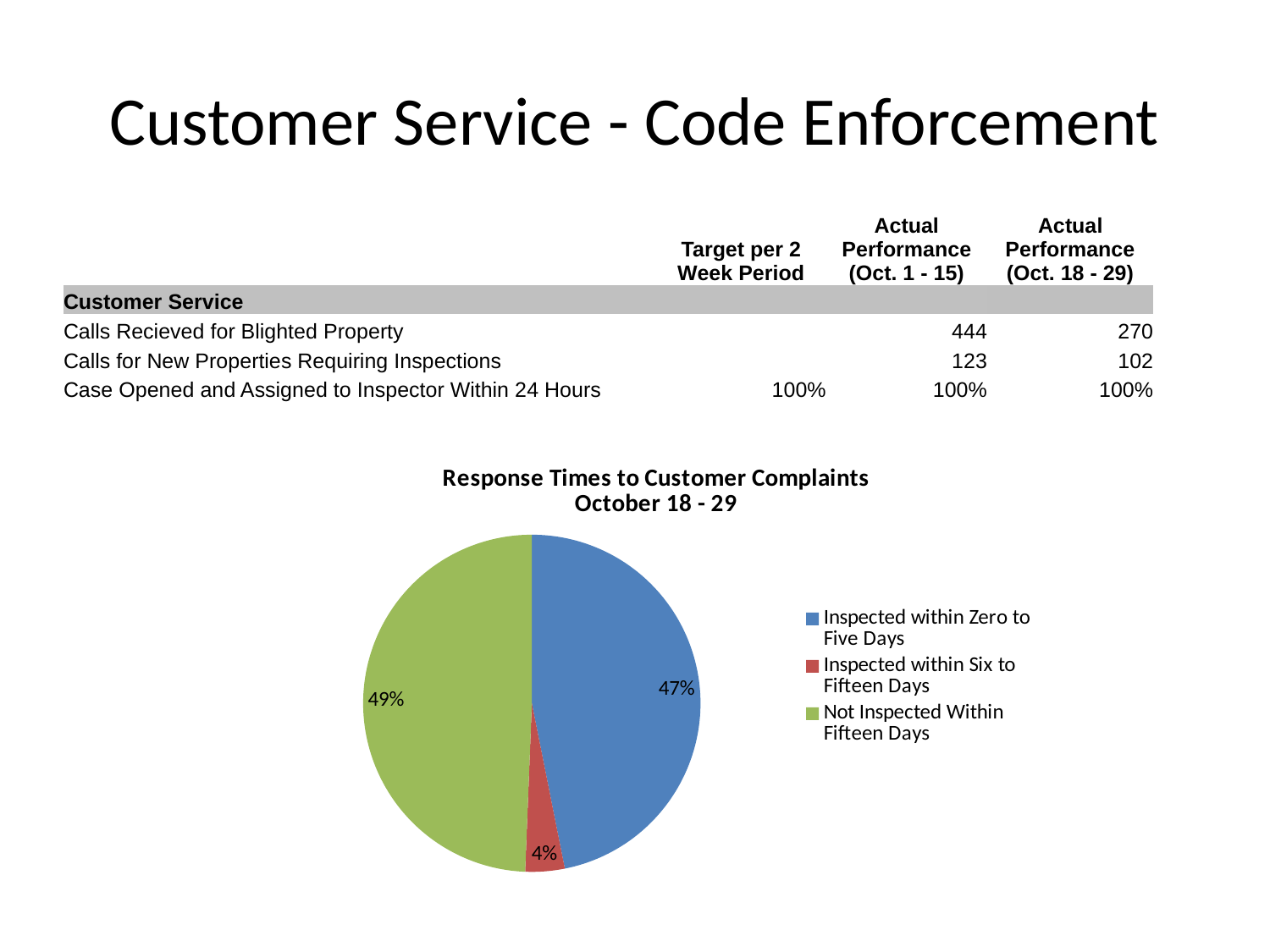
Which is larger: the share for 'Inspected within Zero to Five Days' or the share for 'Inspected within Six to Fifteen Days'? Inspected within Zero to Five Days Which category has the largest slice of the pie? Not Inspected Within Fifteen Days What is the difference in percentage points between 'Not Inspected Within Fifteen Days' and 'Inspected within Zero to Five Days'? 2 Which category has the smallest slice of the pie? Inspected within Six to Fifteen Days What kind of chart is shown on the slide? pie chart How many categories does the pie chart show? 3 What colour is the slice for 'Not Inspected Within Fifteen Days'? green What share of the pie is 'Inspected within Six to Fifteen Days'? 4% What is the title of the chart? Response Times to Customer Complaints October 18 - 29 What share of the pie is 'Not Inspected Within Fifteen Days'? 49% What share of the pie is 'Inspected within Zero to Five Days'? 47% What is the difference in percentage points between 'Not Inspected Within Fifteen Days' and 'Inspected within Six to Fifteen Days'? 45